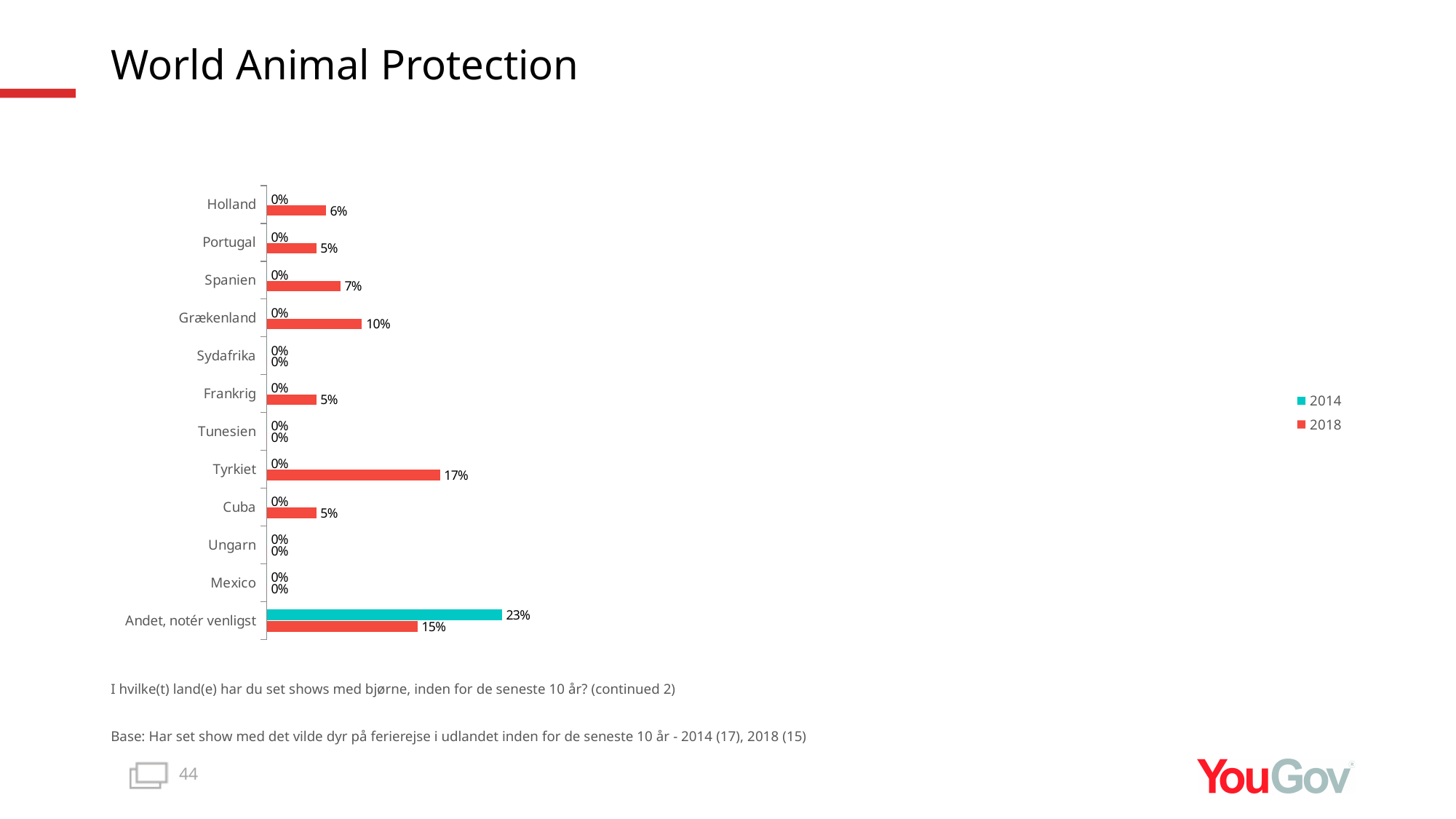
Which country has the highest 2018 value? Tyrkiet What is the 2018 value for Tyrkiet? 17% What is the 2018 value for Grækenland? 10% What is the 2018 value for Holland? 6% How many categories are shown on the chart? 12 What is the 2014 value for Andet, notér venligst? 23% What is the difference between the 2018 values for Tyrkiet and Grækenland? 7 percentage points What is the difference between the 2014 and 2018 values for Andet, notér venligst? 8 percentage points What kind of chart is shown on the slide? Bar chart How many series does the legend list? 2 Which colour represents the 2014 series in the legend? Teal Which is larger for 2018: Spanien or Portugal? Spanien